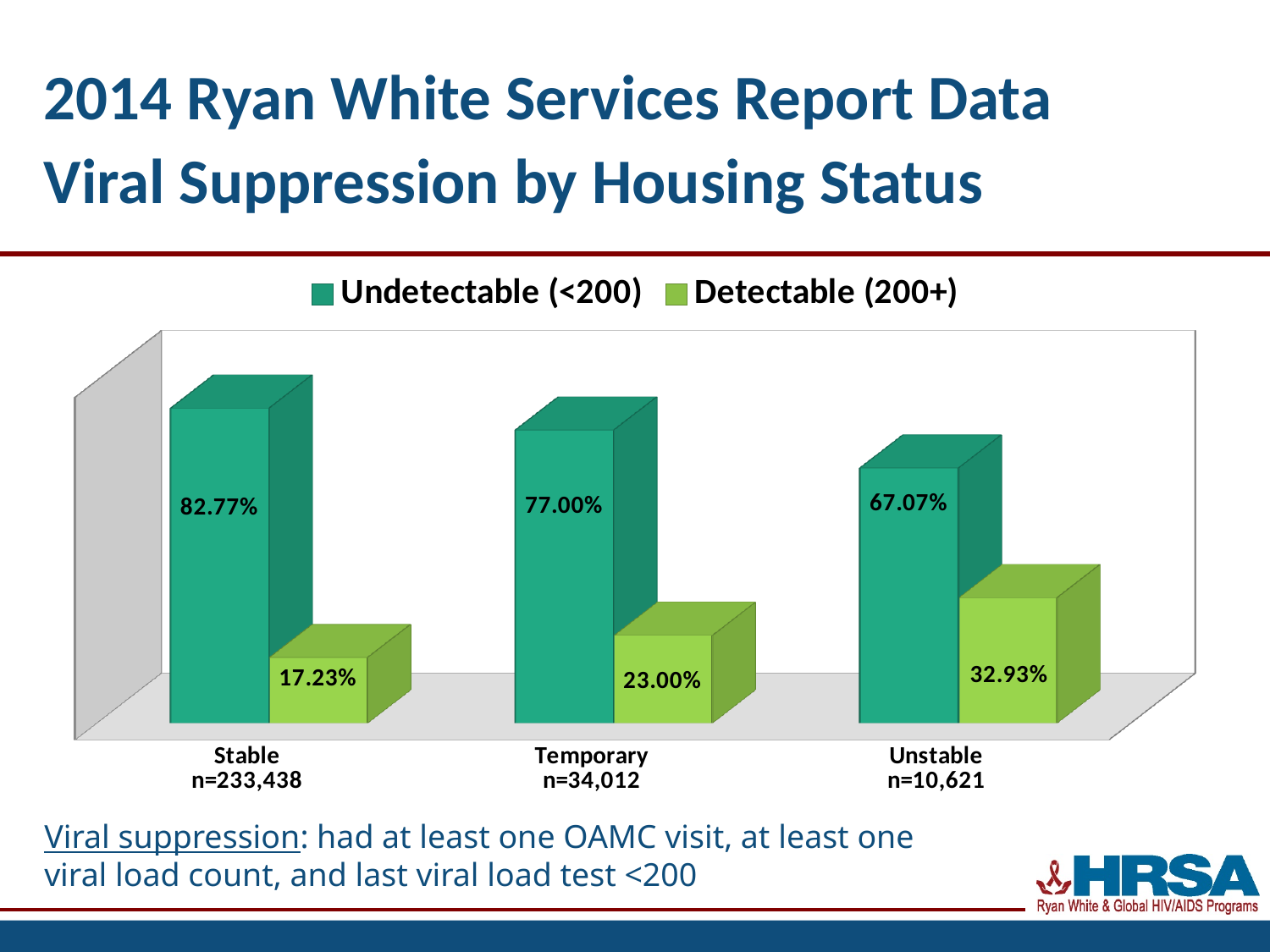
How many series does the legend list? 2 How many housing status categories are shown on the chart? 3 Which housing status has the highest Undetectable (<200) value? Stable What is the Undetectable (<200) value for the Stable housing status? 82.77% What is the Detectable (200+) value for the Unstable housing status? 32.93% What is the Undetectable (<200) value for the Temporary housing status? 77.00% What is the Detectable (200+) value for the Stable housing status? 17.23% What kind of chart is shown on the slide? Bar chart What is the difference between the Undetectable (<200) values for Stable and Unstable? 15.70% Does the Undetectable (<200) value rise or fall from Stable to Unstable? Fall Which is larger: the Detectable (200+) value for Temporary or for Unstable? Unstable Which housing status has the lowest Detectable (200+) value? Stable